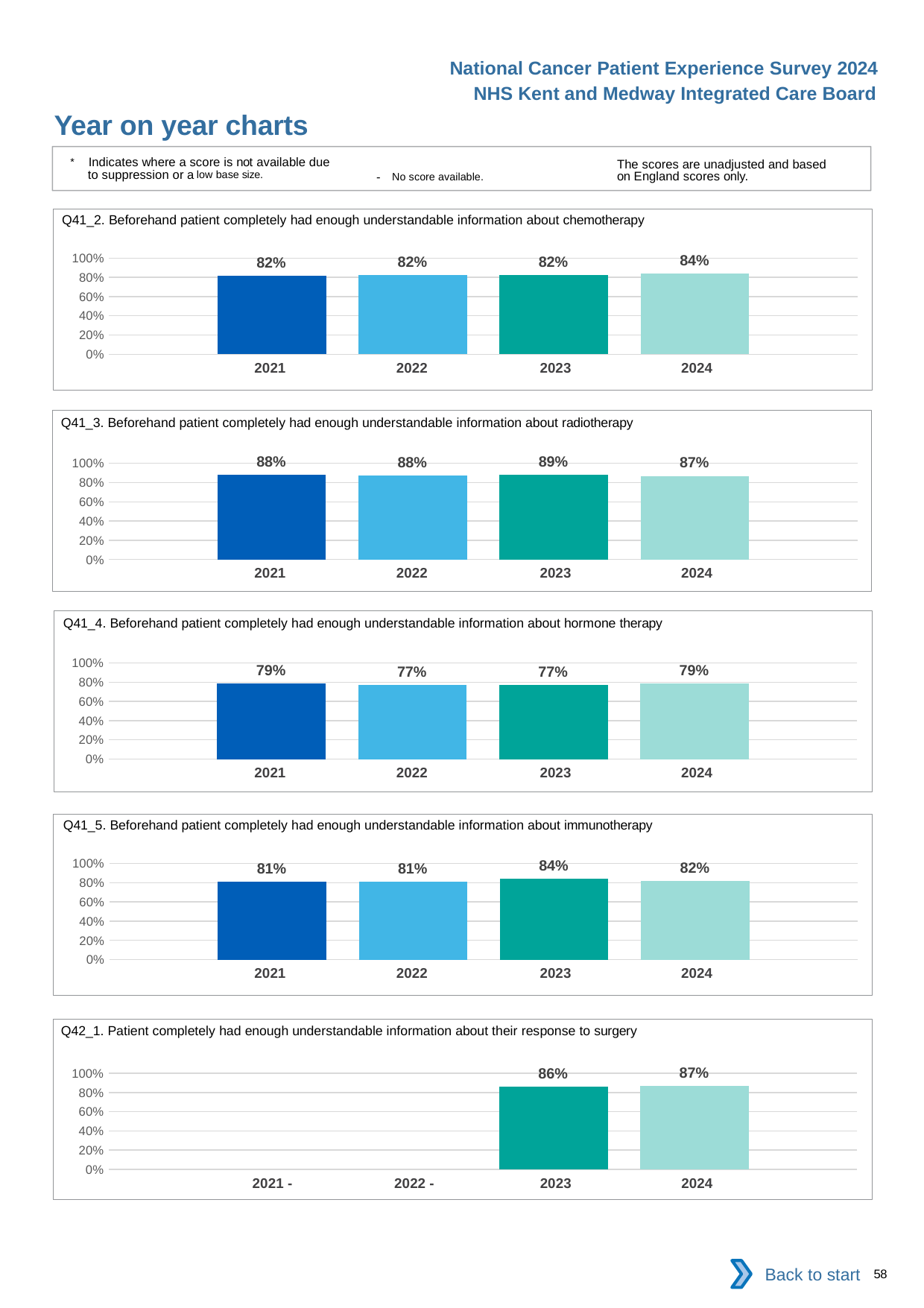
What kind of chart is the Q41_4 chart (hormone therapy)? Bar chart In the Q41_2 chart (chemotherapy), is the value for 2023 greater or less than 60%? greater In the Q42_1 chart (response to surgery), how many years have a bar plotted? 2 In the Q41_3 chart (radiotherapy), what is the difference between the 2023 and 2024 values? 2% In the Q41_3 chart (radiotherapy), what is the value for 2024? 87% How many year categories are shown on the x axis of the Q41_2 chart (chemotherapy)? 4 In the Q41_3 chart (radiotherapy), which year has the highest value? 2023 In the Q41_4 chart (hormone therapy), what is the difference between the 2021 and 2022 values? 2% In the Q41_2 chart (chemotherapy), what is the value for 2024? 84% In the Q41_5 chart (immunotherapy), which year has the highest value? 2023 In the Q42_1 chart (response to surgery), which is larger, the 2023 value or the 2024 value? 2024 In the Q41_5 chart (immunotherapy), what is the value for 2022? 81%